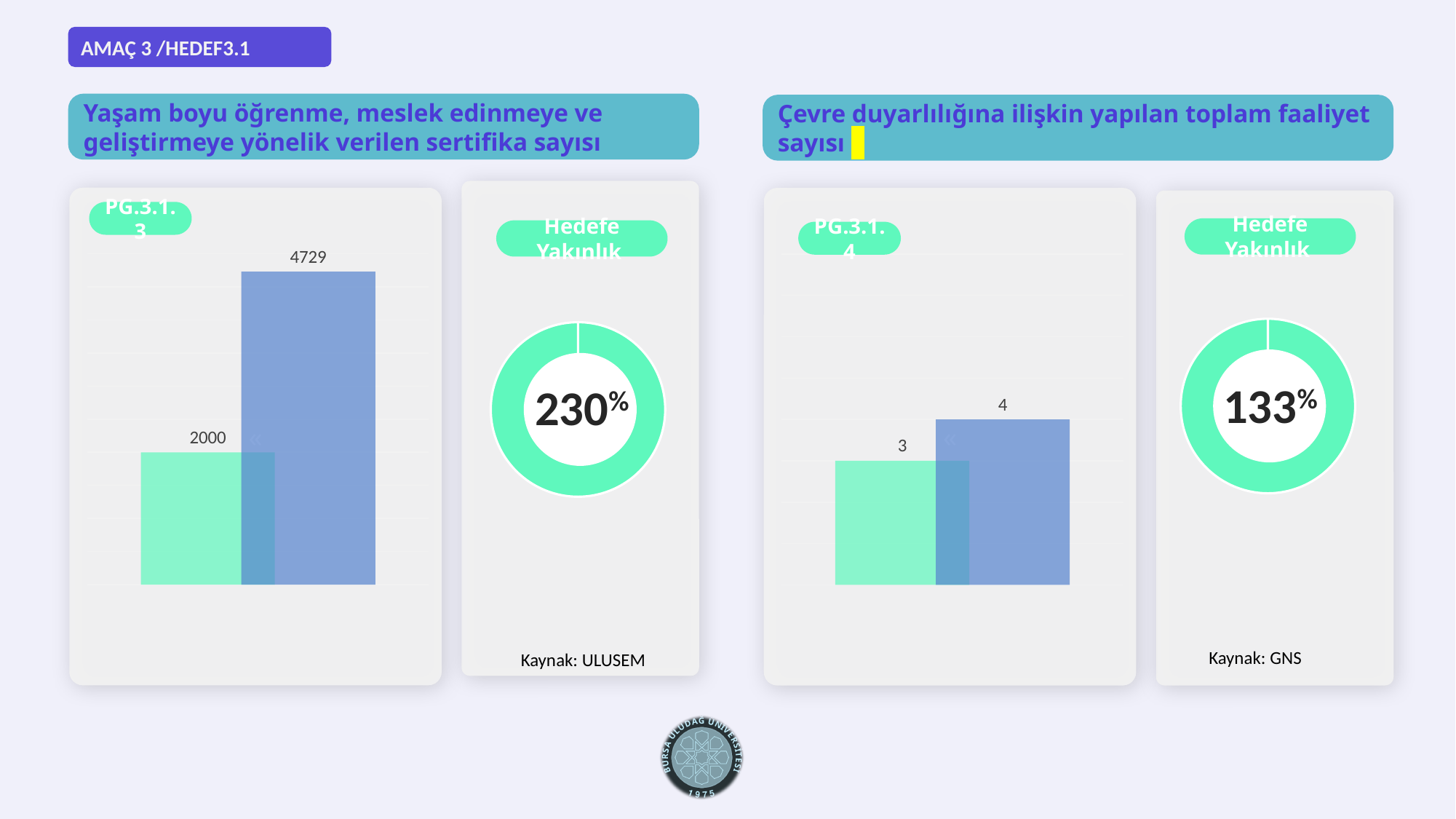
In the PG.3.1.4 chart, what value is printed on the blue bar? 4 In the PG.3.1.3 chart, what is the difference between the two bar values? 2729 In the PG.3.1.4 chart, what value is printed on the green bar? 3 What source is cited below the Hedefe Yakınlık donut chart on the right side of the slide? Kaynak: GNS In the PG.3.1.3 chart, which bar is higher, the green bar or the blue bar? the blue bar In the PG.3.1.3 chart, what value is printed on the taller blue bar? 4729 What percentage is shown in the Hedefe Yakınlık donut chart next to the PG.3.1.3 chart? 230% What percentage is shown in the Hedefe Yakınlık donut chart next to the PG.3.1.4 chart? 133% In the PG.3.1.4 chart, what is the difference between the blue bar and the green bar? 1 How many bars are plotted in the PG.3.1.3 chart? 2 In the PG.3.1.3 chart, what value is printed on the green bar? 2000 What kind of chart is the PG.3.1.3 chart? bar chart